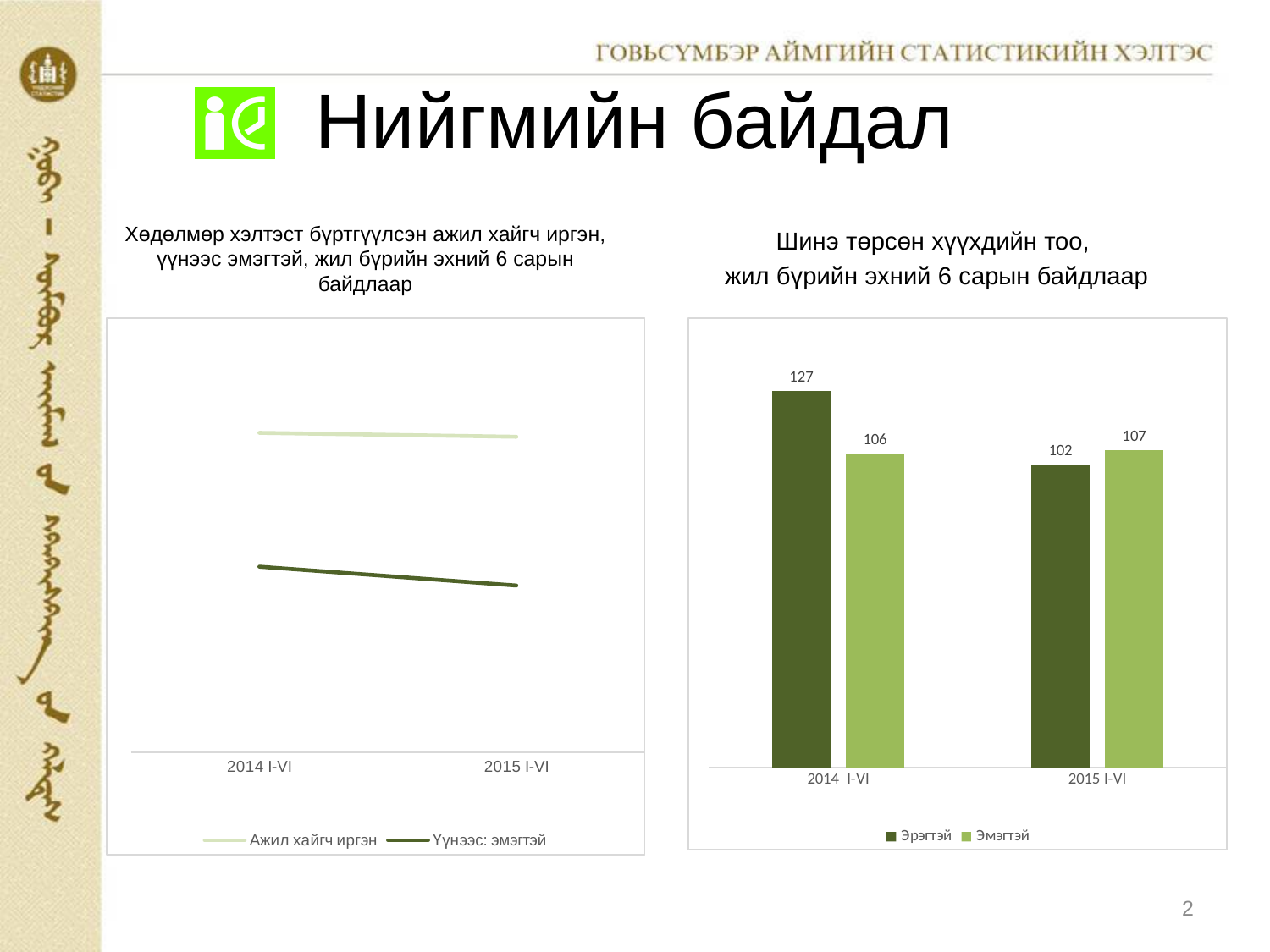
On the right chart (Шинэ төрсөн хүүхдийн тоо), what is the value for Эрэгтэй in 2015 I-VI? 102 On the left chart (Хөдөлмөр хэлтэст бүртгүүлсэн ажил хайгч иргэн), what kind of chart is it? Line chart On the right chart (Шинэ төрсөн хүүхдийн тоо), how many series does the legend list? 2 On the left chart (Хөдөлмөр хэлтэст бүртгүүлсэн ажил хайгч иргэн), which series is higher in 2014 I-VI, Ажил хайгч иргэн or Үүнээс: эмэгтэй? Ажил хайгч иргэн On the right chart (Шинэ төрсөн хүүхдийн тоо), what is the difference between the Эрэгтэй values for 2014 I-VI and 2015 I-VI? 25 On the right chart (Шинэ төрсөн хүүхдийн тоо), which is larger in 2015 I-VI, Эрэгтэй or Эмэгтэй? Эмэгтэй On the right chart (Шинэ төрсөн хүүхдийн тоо), what is the value for Эрэгтэй in 2014 I-VI? 127 On the right chart (Шинэ төрсөн хүүхдийн тоо), which bar has the highest value? Эрэгтэй, 2014 I-VI On the right chart (Шинэ төрсөн хүүхдийн тоо), which bar has the lowest value? Эрэгтэй, 2015 I-VI On the left chart (Хөдөлмөр хэлтэст бүртгүүлсэн ажил хайгч иргэн), does the Үүнээс: эмэгтэй line rise or fall from 2014 I-VI to 2015 I-VI? Fall On the right chart (Шинэ төрсөн хүүхдийн тоо), what kind of chart is it? Bar chart On the right chart (Шинэ төрсөн хүүхдийн тоо), what is the value for Эмэгтэй in 2015 I-VI? 107